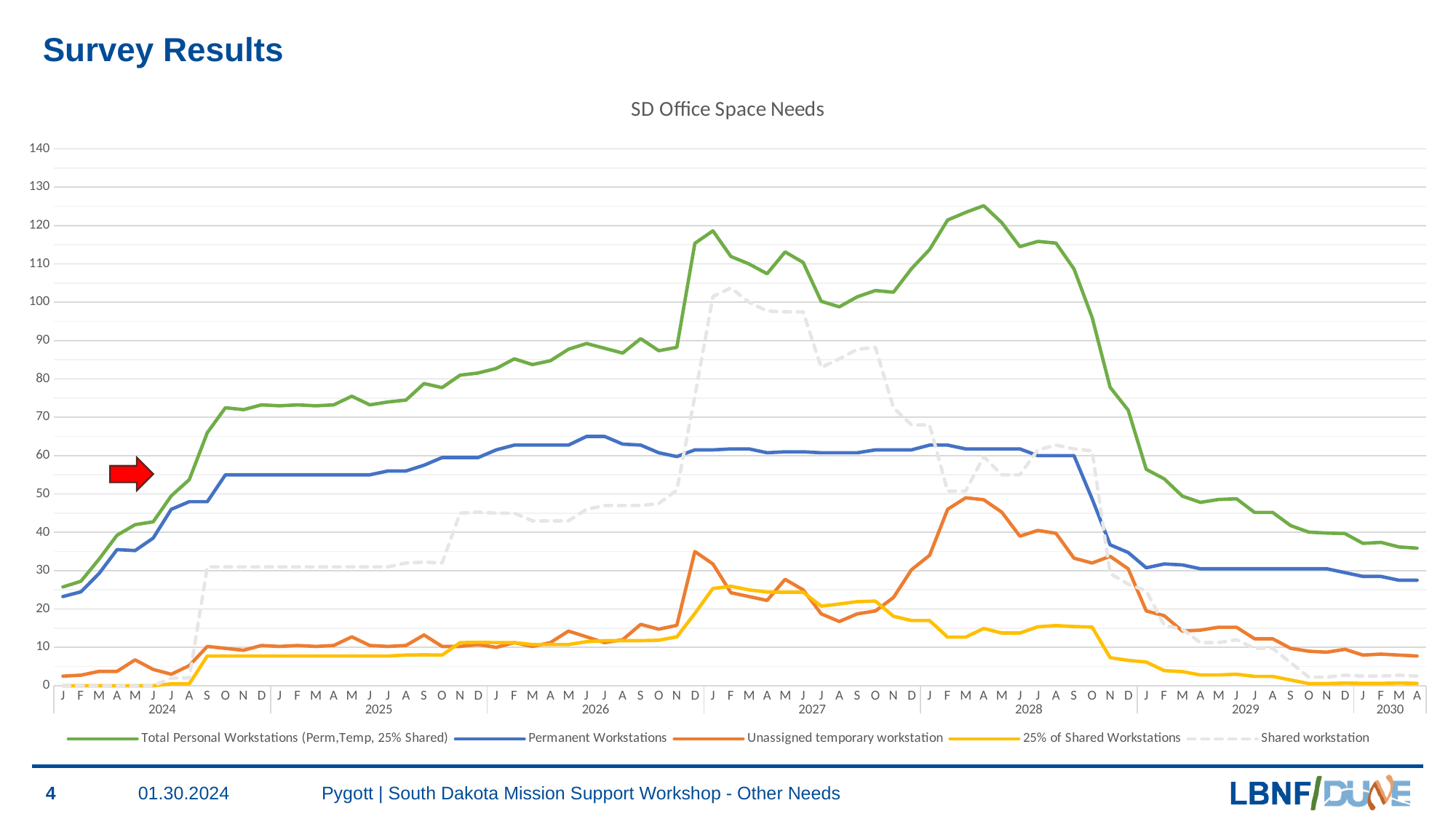
Do the values for Permanent Workstations rise or fall from January 2024 to December 2024? rise In which year does Total Personal Workstations (Perm,Temp, 25% Shared) reach its highest value? 2028 Is the peak value of Unassigned temporary workstation in 2028 greater or less than 40? greater Is the value for Permanent Workstations in January 2025 greater or less than 50? greater Which series has the highest values across the whole chart? Total Personal Workstations (Perm,Temp, 25% Shared) What is the title of the chart? SD Office Space Needs Is the value for Permanent Workstations in April 2030 greater or less than 30? less What kind of chart is shown on the slide? line chart In January 2027, which is larger: Permanent Workstations or Shared workstation? Shared workstation How many series does the legend list? 5 Do the values for Total Personal Workstations (Perm,Temp, 25% Shared) rise or fall from January 2029 to April 2030? fall